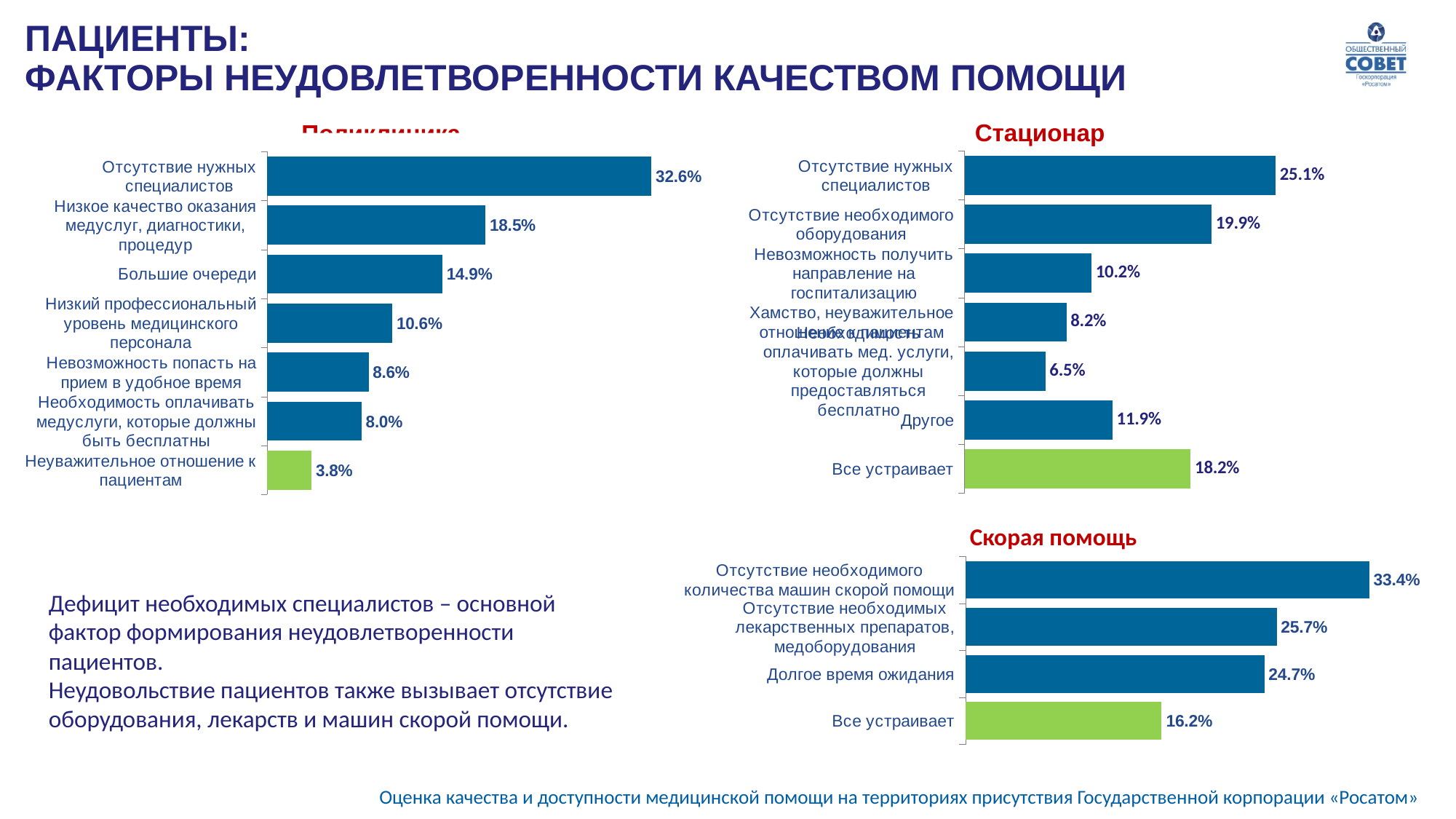
In the «Стационар» chart, which is larger: «Другое» or «Невозможность получить направление на госпитализацию»? Другое In the «Скорая помощь» chart, what is the value for «Долгое время ожидания»? 24.7% In the top-left chart (Поликлиника), what is the difference between «Отсутствие нужных специалистов» and «Низкое качество оказания медуслуг, диагностики, процедур»? 14.1% In the «Стационар» chart, what is the value for «Все устраивает»? 18.2% How many categories are shown in the top-left chart (Поликлиника)? 7 How many categories are shown in the «Скорая помощь» chart? 4 In the «Скорая помощь» chart, which category has the highest value? Отсутствие необходимого количества машин скорой помощи In the top-left chart (Поликлиника), which category has the highest value? Отсутствие нужных специалистов In the top-left chart (Поликлиника), what is the value for «Большие очереди»? 14.9% In the top-left chart (Поликлиника), which category has the lowest value? Неуважительное отношение к пациентам In the «Стационар» chart, what is the value for «Отсутствие необходимого оборудования»? 19.9% What type of chart is the «Скорая помощь» chart? Bar chart